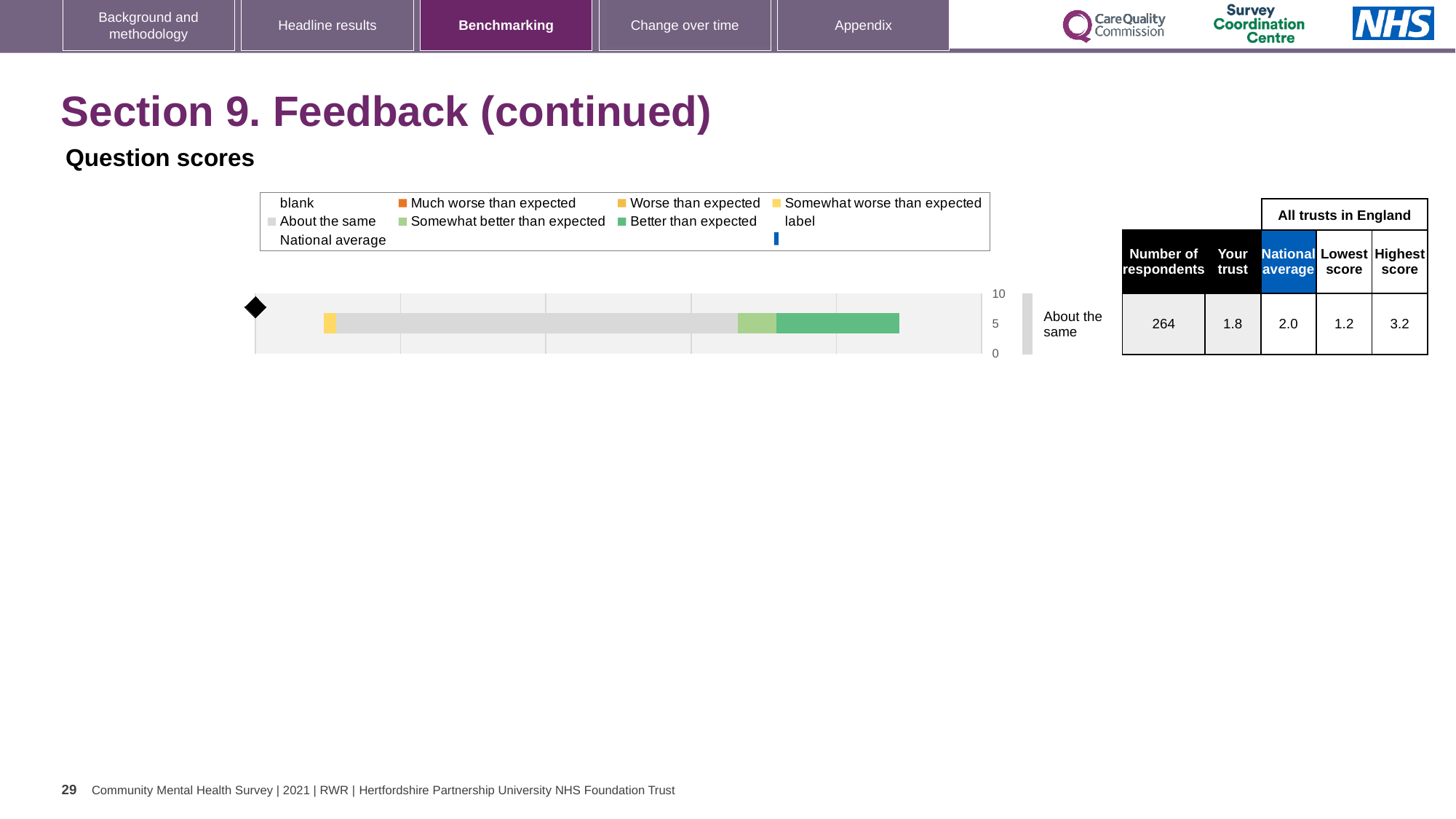
How many entries does the chart legend list? 9 In the table next to the chart, which is larger for 'About the same': the 'Your trust' score or the national average? National average What colour represents 'Better than expected' in the chart legend? green In the table next to the chart, what is the 'Your trust' score for 'About the same'? 1.8 What kind of chart is shown on the slide? bar chart In the table next to the chart, what is the number of respondents for 'About the same'? 264 Which legend category occupies the largest segment of the bar? About the same In the table next to the chart, what is the national average score for 'About the same'? 2.0 How many question rows (categories) are plotted in the bar chart? 1 In the table next to the chart, what is the difference between the highest score and the lowest score for 'About the same'? 2.0 What is the highest value shown on the chart's axis? 10 What is the label of the single row plotted in the bar chart? About the same